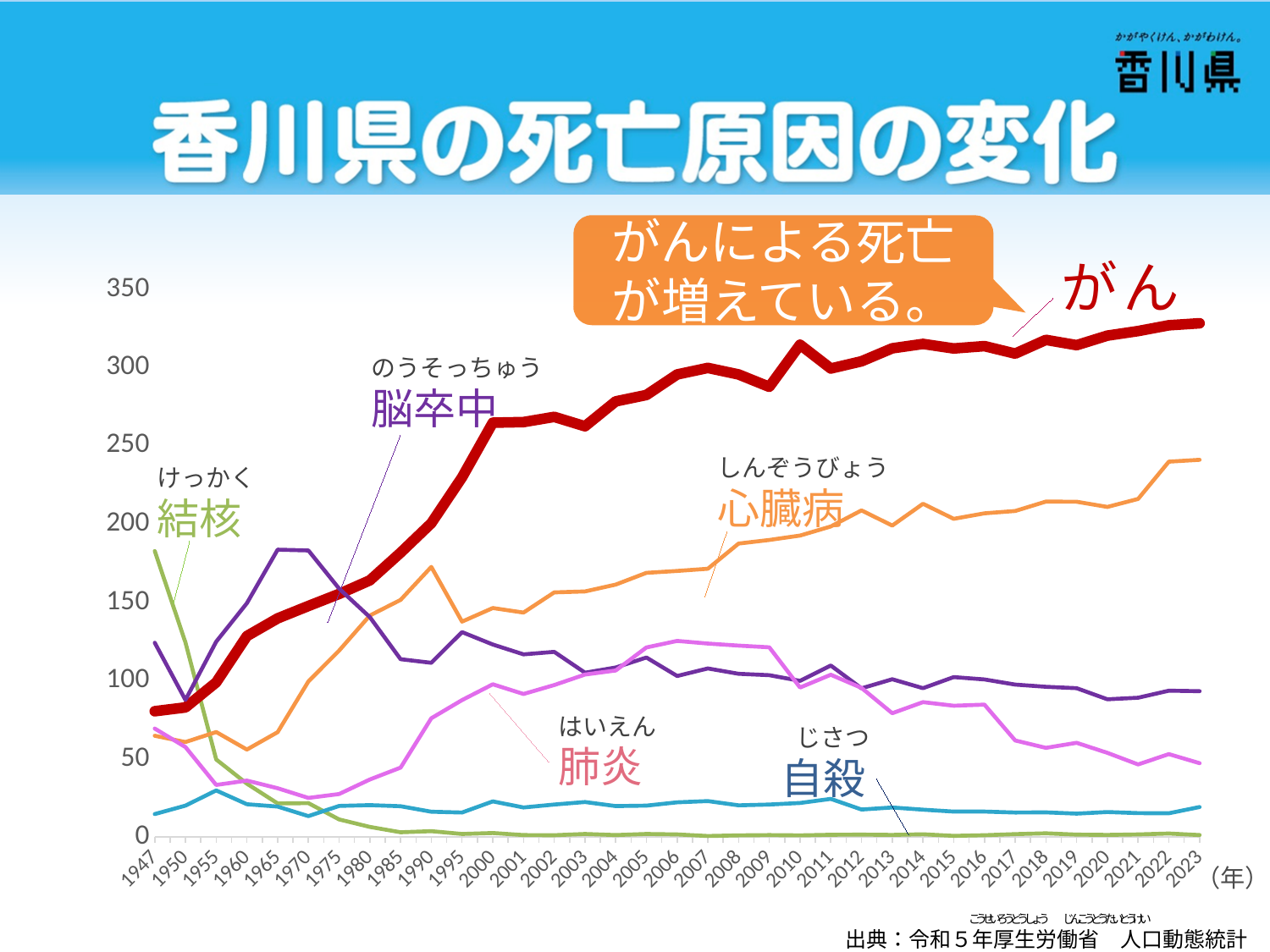
What is the title of the chart on the slide? 香川県の死亡原因の変化 Which cause of death has the lowest value in 2023? 結核 What kind of chart is shown on the slide? line chart Is the value for がん in 2023 greater or less than 300? greater Does the value for がん rise or fall from 1947 to 2023? rise Which cause of death has the highest value in 2023? がん How many causes of death (series) are labelled on the chart? 6 Is the value for 脳卒中 in 2023 greater or less than 100? less Is the value for 心臓病 in 2023 greater or less than 200? greater Which is larger in 2023, the value for がん or the value for 心臓病? がん Does the value for 結核 rise or fall from 1947 to 2023? fall Which is larger in 1947, the value for 結核 or the value for 自殺? 結核